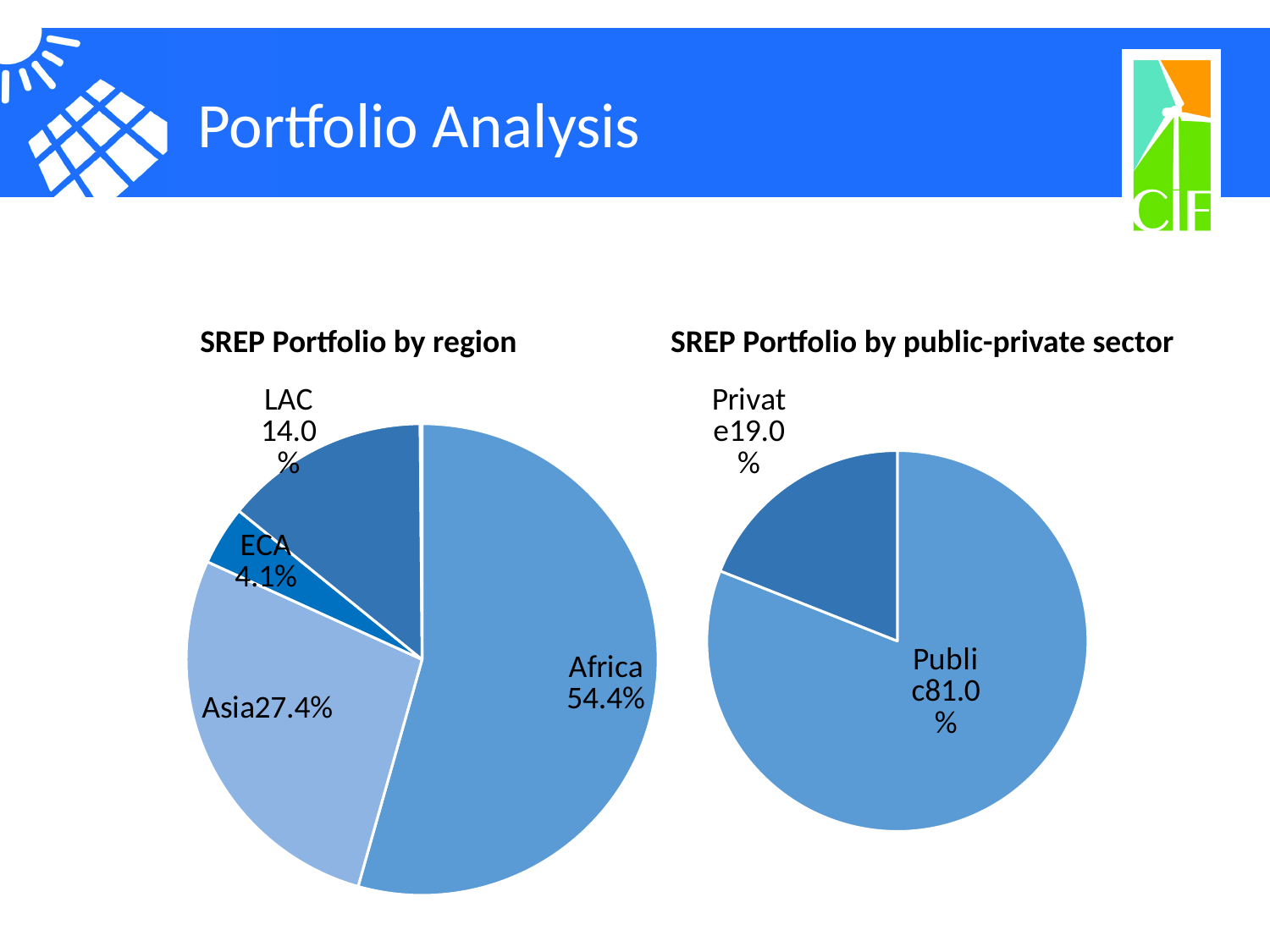
In the 'SREP Portfolio by region' chart, which region has the largest share? Africa In the 'SREP Portfolio by public-private sector' chart, which sector is larger, Public or Private? Public In the 'SREP Portfolio by region' chart, what share does LAC have? 14.0% In the 'SREP Portfolio by region' chart, what share does Asia have? 27.4% In the 'SREP Portfolio by region' chart, what is the difference between the Africa and Asia shares? 27.0% In the 'SREP Portfolio by public-private sector' chart, what share does Private have? 19.0% In the 'SREP Portfolio by public-private sector' chart, what share does Public have? 81.0% In the 'SREP Portfolio by region' chart, what share does ECA have? 4.1% In the 'SREP Portfolio by region' chart, what share does Africa have? 54.4% What kind of chart is 'SREP Portfolio by public-private sector'? Pie chart